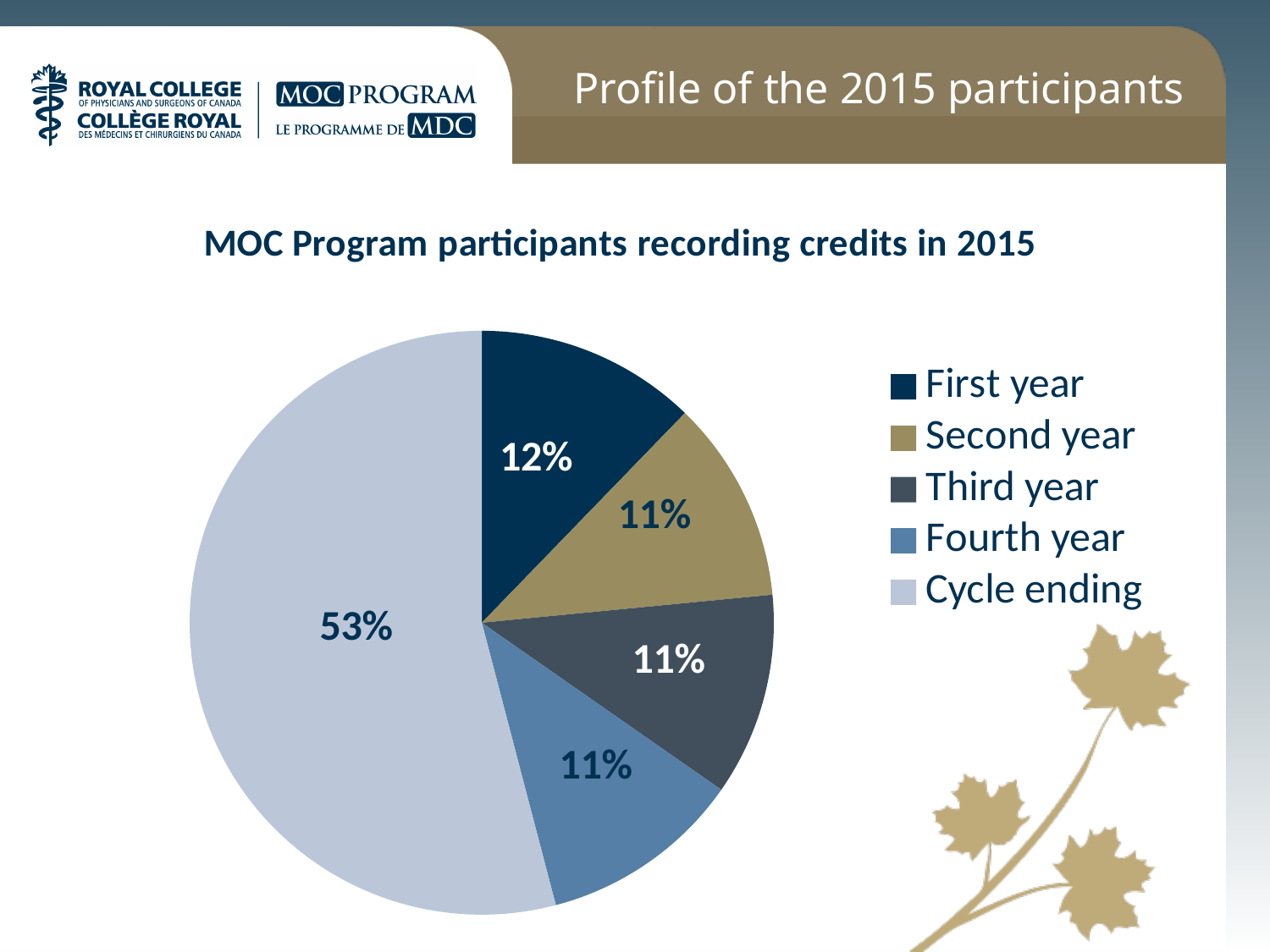
What is the value shown for Second year? 11% Which category has the largest slice of the pie? Cycle ending How many slices does the pie chart have? 5 How many entries does the legend list? 5 What share of the pie is First year? 12% What is the value shown for Fourth year? 11% What is the difference in percentage points between First year and Third year? 1 What is the difference in percentage points between Cycle ending and First year? 41 Which is larger, the slice for Cycle ending or the slice for First year? Cycle ending What kind of chart is shown on the slide? pie chart What is the title of the chart? MOC Program participants recording credits in 2015 What share of the pie is Cycle ending? 53%